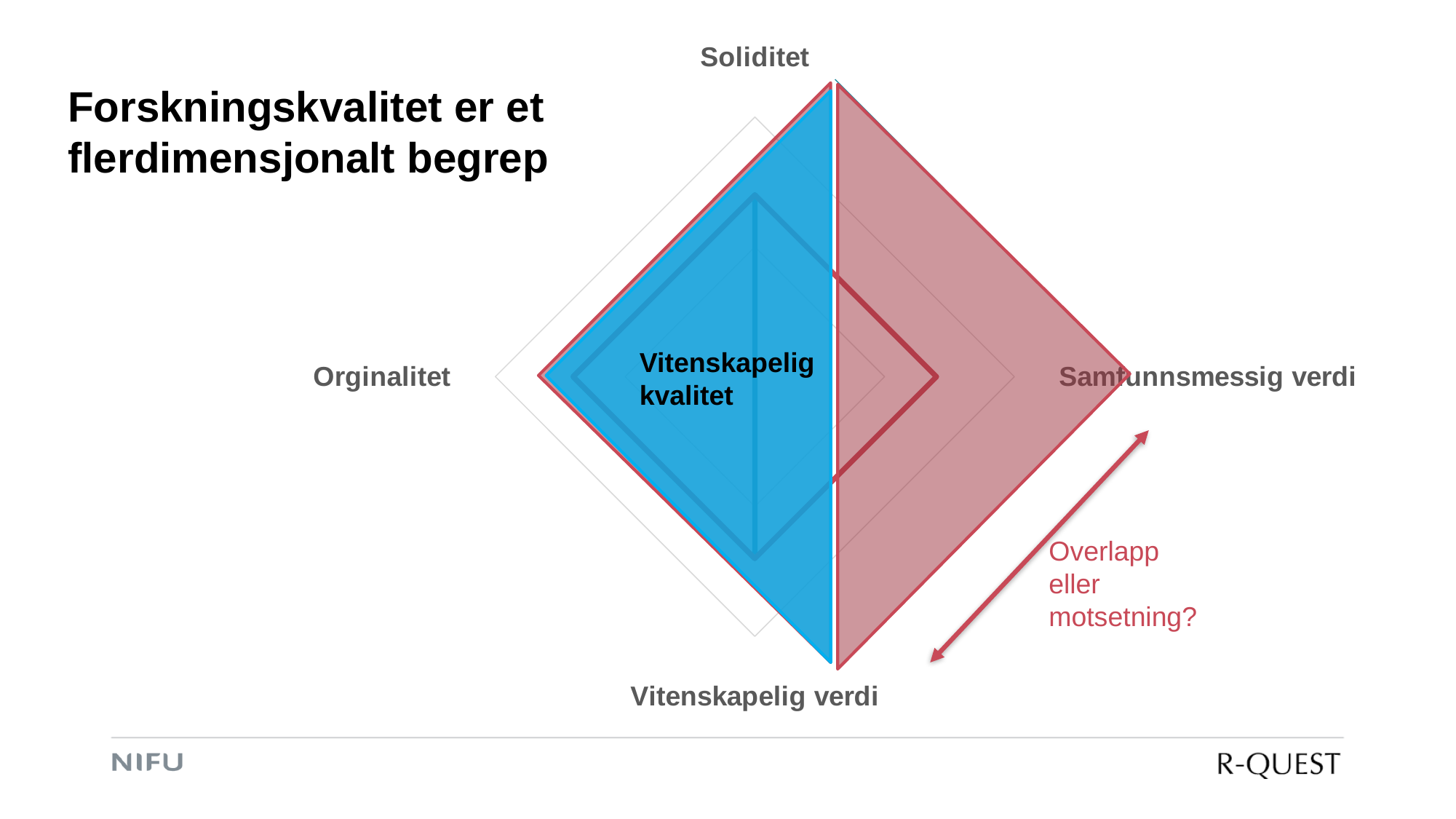
Which dimension is labelled on the left side of the radar chart? Orginalitet Which dimension is labelled at the bottom of the radar chart? Vitenskapelig verdi On the Samfunnsmessig verdi axis, which shape extends further from the centre, the blue one or the red one? the red one Which dimension is labelled at the top of the radar chart? Soliditet How many axes (dimensions) does the radar chart have? 4 What kind of chart is shown on the slide? radar chart